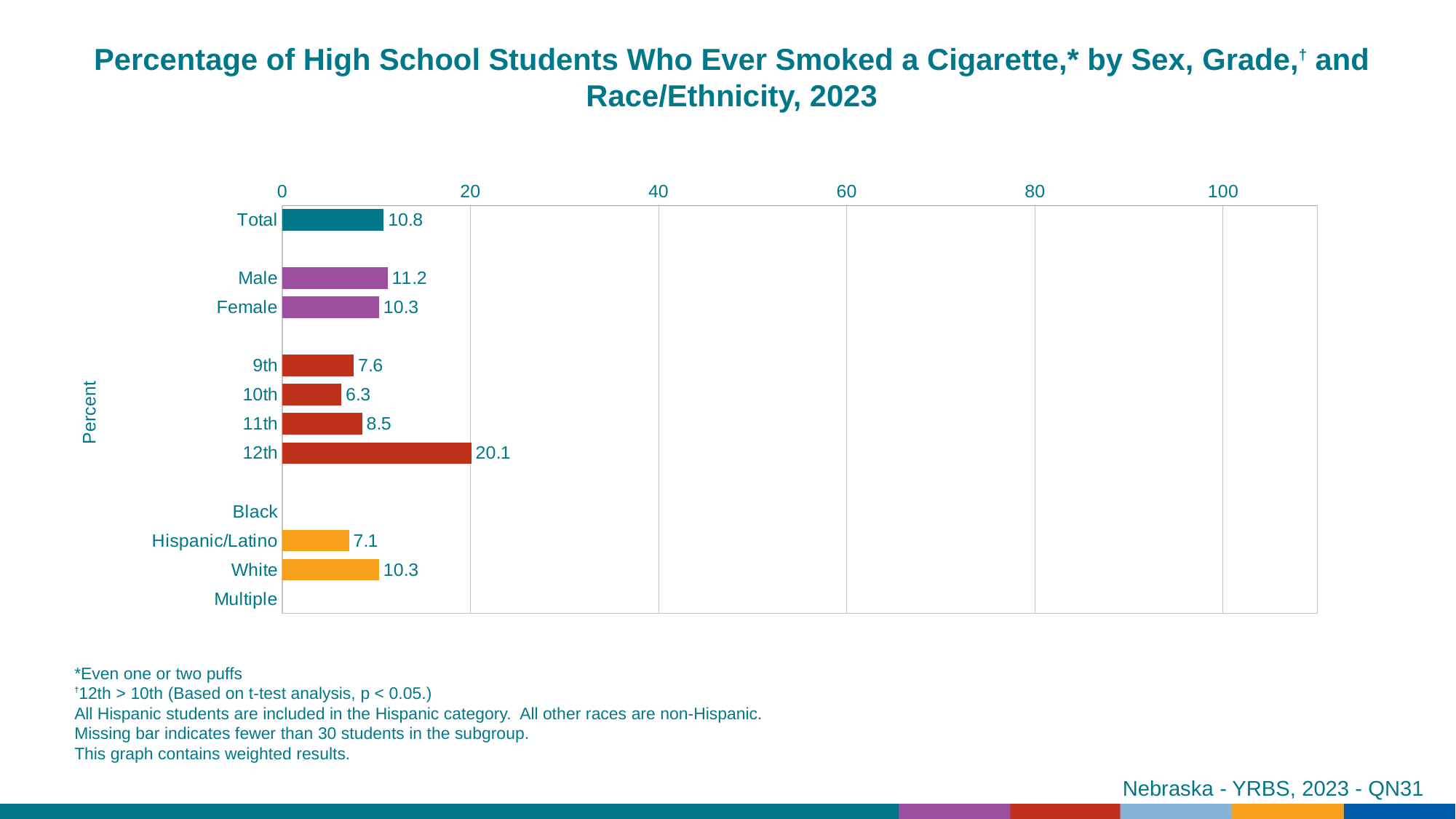
What kind of chart is shown on the slide? bar chart What is the difference between the values for 12th and 10th grade? 13.8 Is the value for 12th grade greater or less than 20? greater Which is larger, the value for White or the value for Hispanic/Latino? White Which grade has the highest value? 12th What is the label on the vertical axis? Percent What is the value for Hispanic/Latino students? 7.1 Which race/ethnicity categories have no bar shown? Black and Multiple What is the difference between the values for Male and Female? 0.9 What is the value for 12th grade students? 20.1 What is the value for Total? 10.8 Which grade has the lowest value? 10th